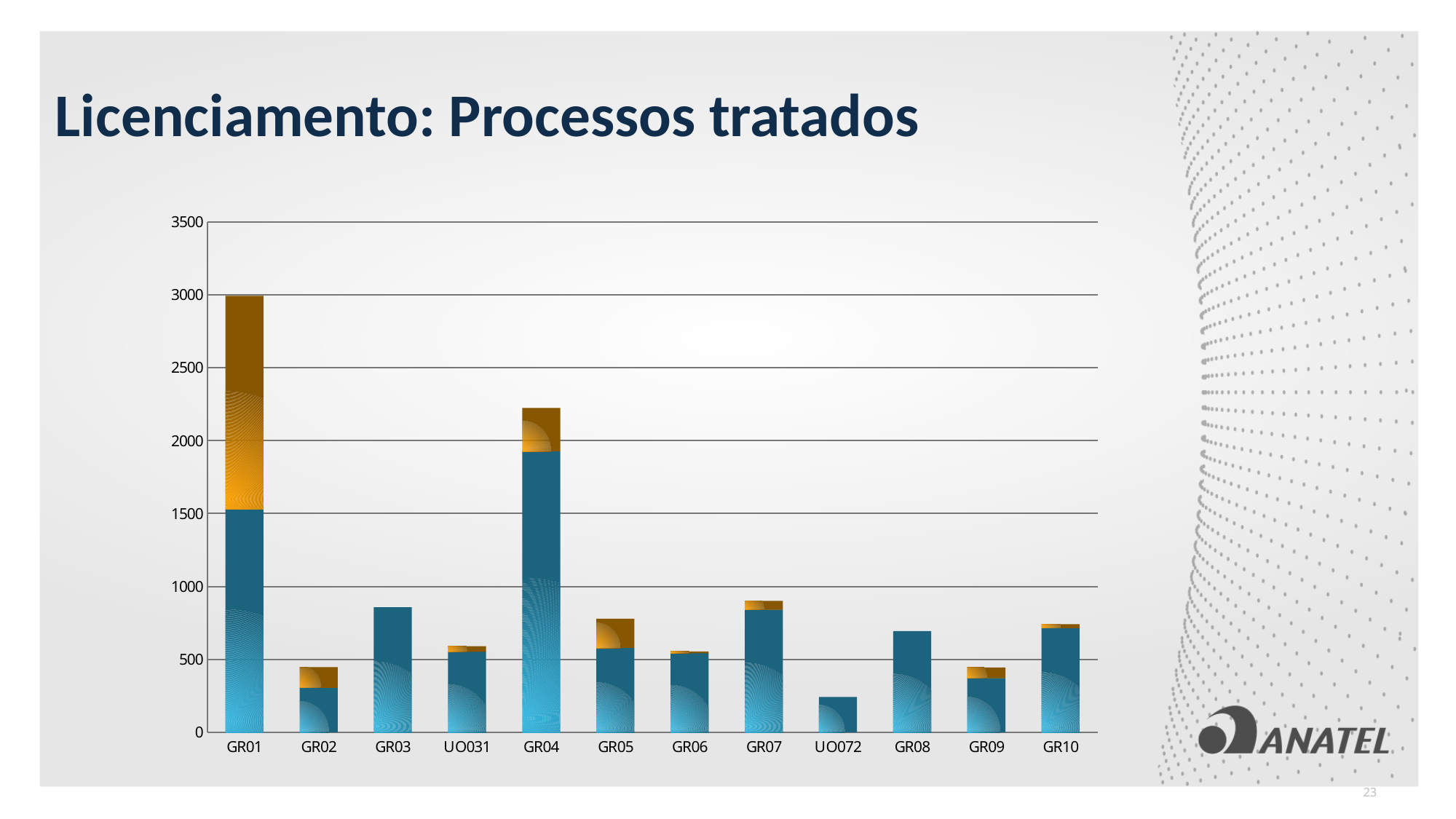
What kind of chart is shown on the slide? Stacked bar chart Is the total value for GR01 greater or less than 2500? greater Is the total value for GR02 greater or less than 500? less How many categories are shown on the x axis of the chart? 12 Which bar is taller, GR04 or GR07? GR04 Is the value for UO072 greater or less than 500? less Which category has the shortest bar in the chart? UO072 Which category has the tallest bar in the chart? GR01 Which bar is taller, GR05 or GR06? GR05 What is the title of the chart on the slide? Licenciamento: Processos tratados